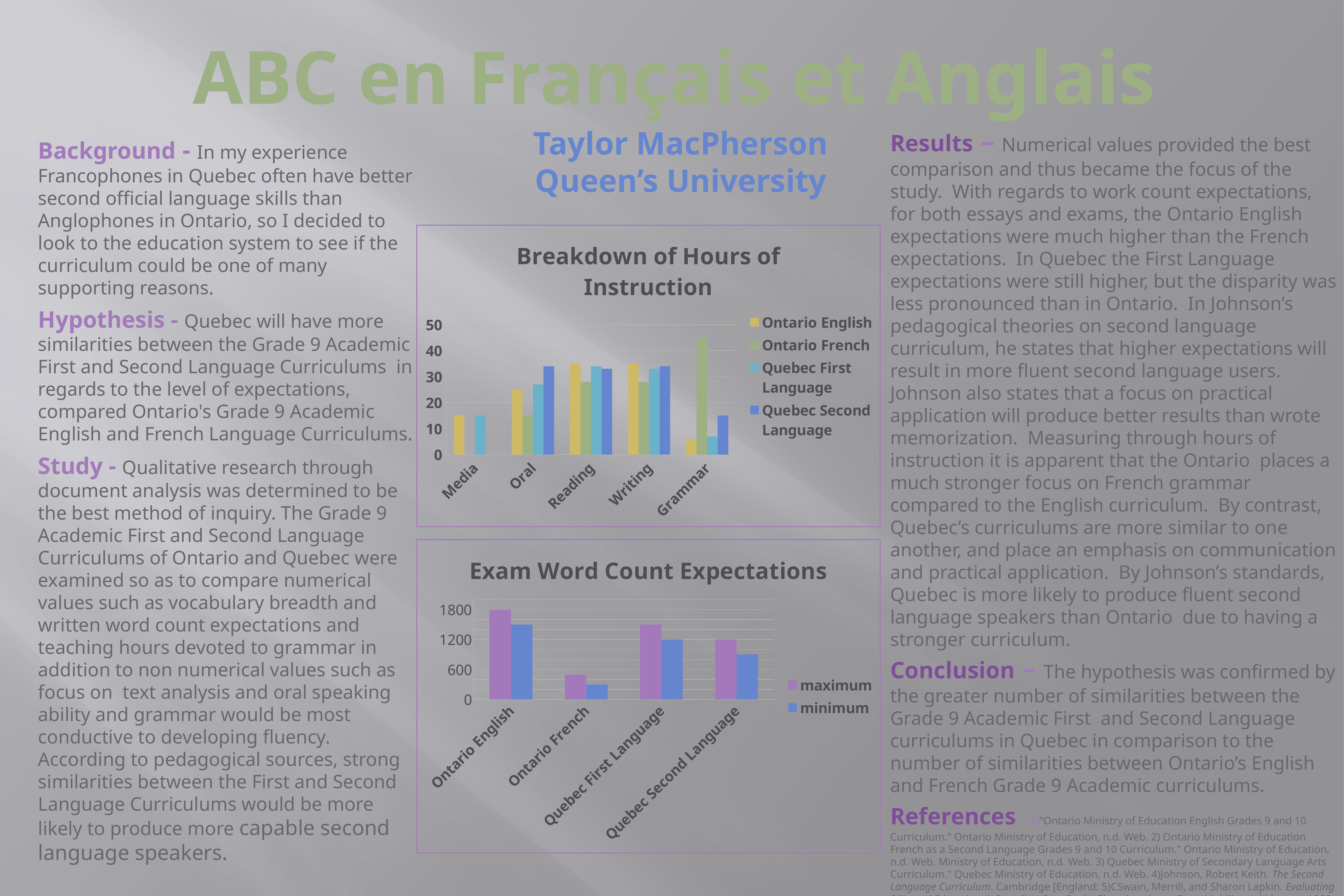
What kind of chart is "Breakdown of Hours of Instruction"? bar chart How many categories are shown on the x axis of "Breakdown of Hours of Instruction"? 5 In "Exam Word Count Expectations", which category has the highest maximum value? Ontario English In "Exam Word Count Expectations", is the maximum value for Ontario French greater or less than 600? less How many series does the legend of "Breakdown of Hours of Instruction" list? 4 In "Breakdown of Hours of Instruction", which series has the highest value for Grammar? Ontario French In "Breakdown of Hours of Instruction", which is larger for Oral: Ontario French or Quebec Second Language? Quebec Second Language How many series does the legend of "Exam Word Count Expectations" list? 2 How many categories are shown in "Exam Word Count Expectations"? 4 In "Breakdown of Hours of Instruction", is the Ontario French value for Grammar greater or less than 40? greater In "Breakdown of Hours of Instruction", is the Ontario English value for Media greater or less than 20? less In "Exam Word Count Expectations", which category has the lowest minimum value? Ontario French